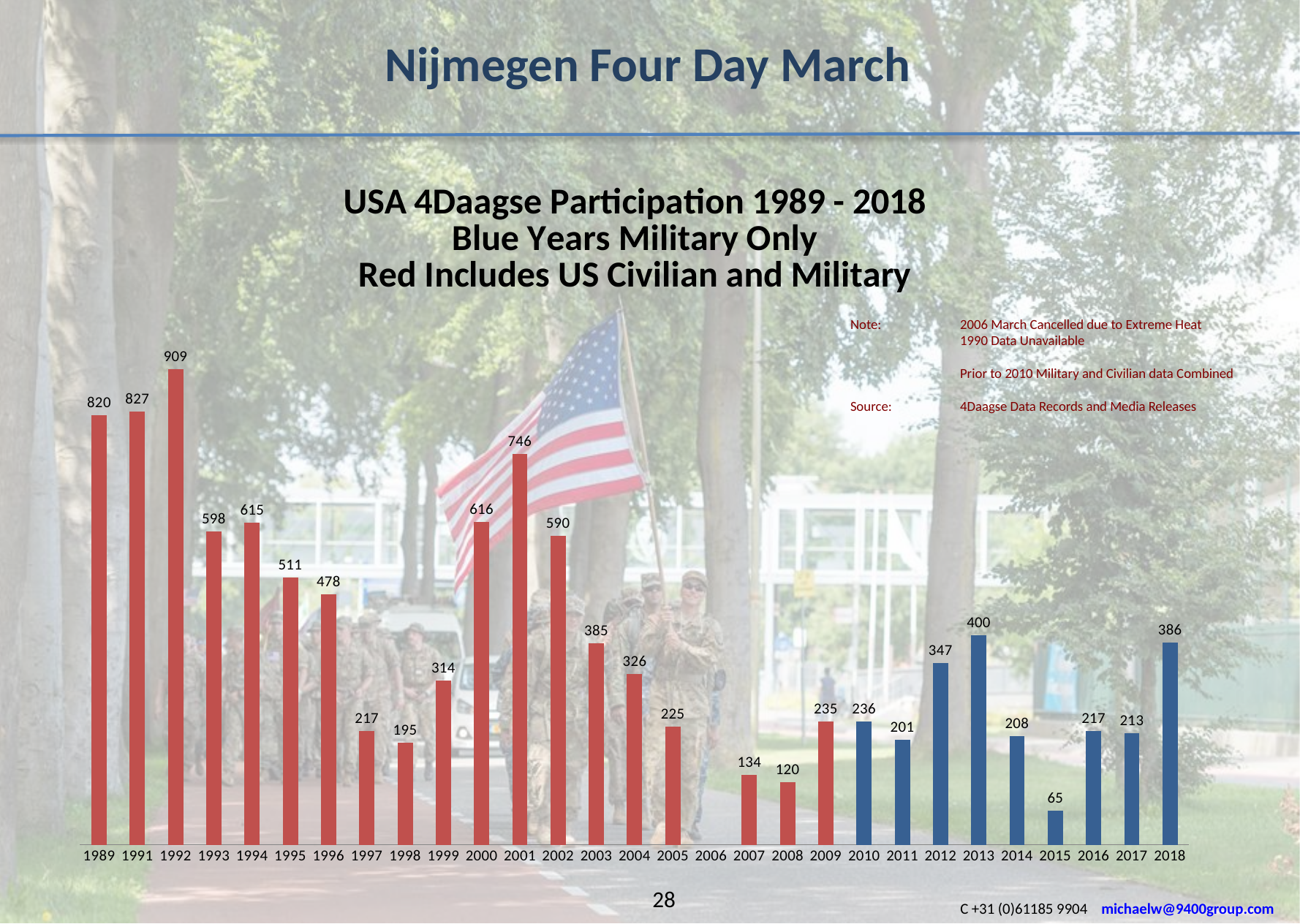
What is the difference between the values for 2001 and 2000? 130 Which is larger, the value for 2012 or the value for 2013? 2013 What is the value for 1992? 909 According to the note, why is there no bar for 2006? March cancelled due to extreme heat Do the values rise or fall from 1992 to 1998? fall What is the value for 2018? 386 What is the difference between the values for 1991 and 1989? 7 Which year has the highest value? 1992 How many year labels are on the x axis? 29 What kind of chart is shown? bar chart What is the value for 2001? 746 Which year has the lowest value? 2015